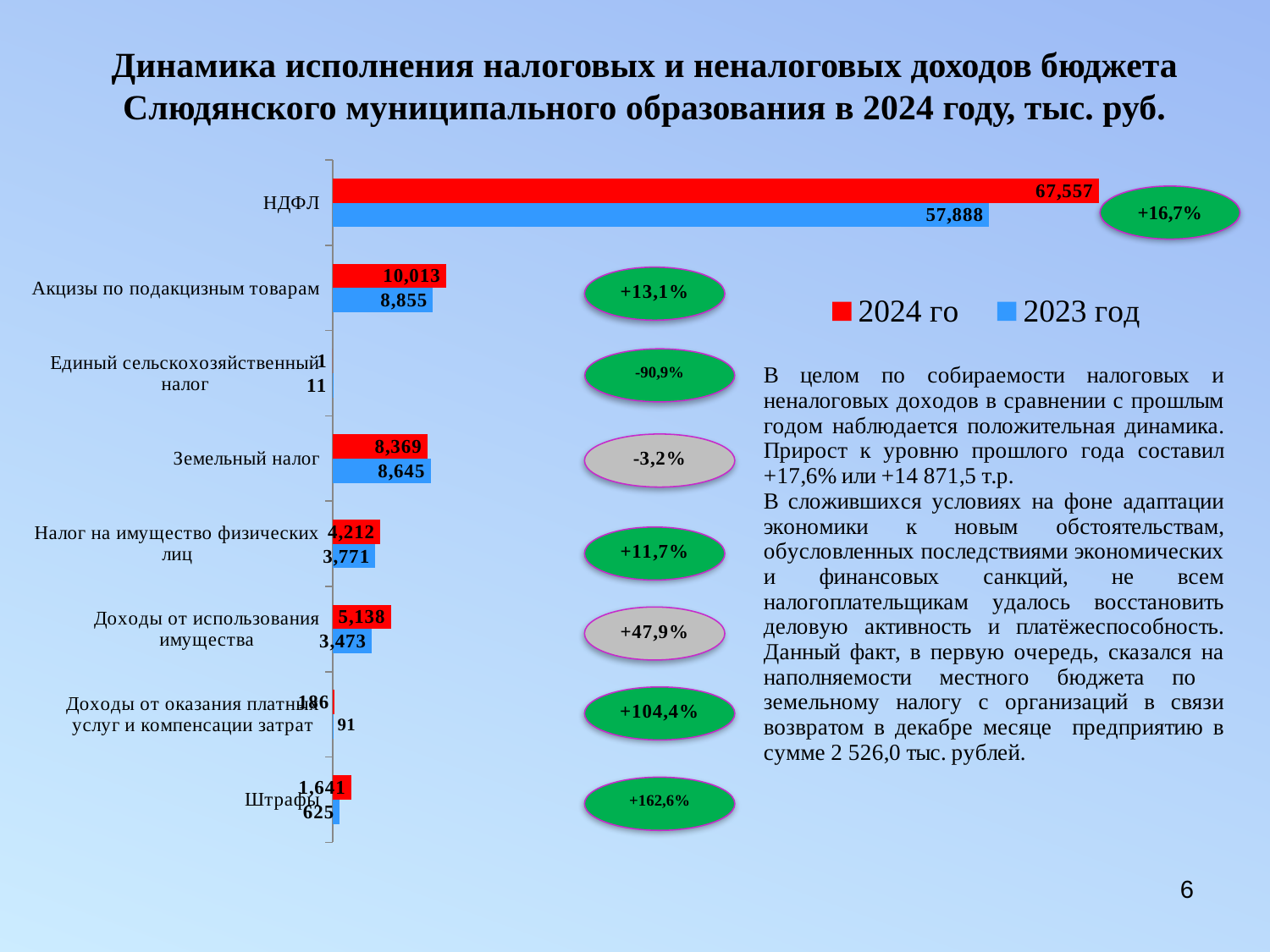
For Земельный налог, which year has the larger value, 2024 or 2023? 2023 What is the 2023 value for Акцизы по подакцизным товарам? 8,855 How many series does the chart legend list? 2 What is the 2024 value for Доходы от использования имущества? 5,138 What kind of chart is shown on the slide? bar chart Which category has the highest 2024 value? НДФЛ Which colour represents the 2023 series in the chart? blue What is the 2023 value for Штрафы? 625 How many categories are shown on the chart? 8 Which category has the lowest 2024 value? Единый сельскохозяйственный налог What is the 2024 value for НДФЛ? 67,557 What is the difference between the 2024 and 2023 values for НДФЛ? 9,669